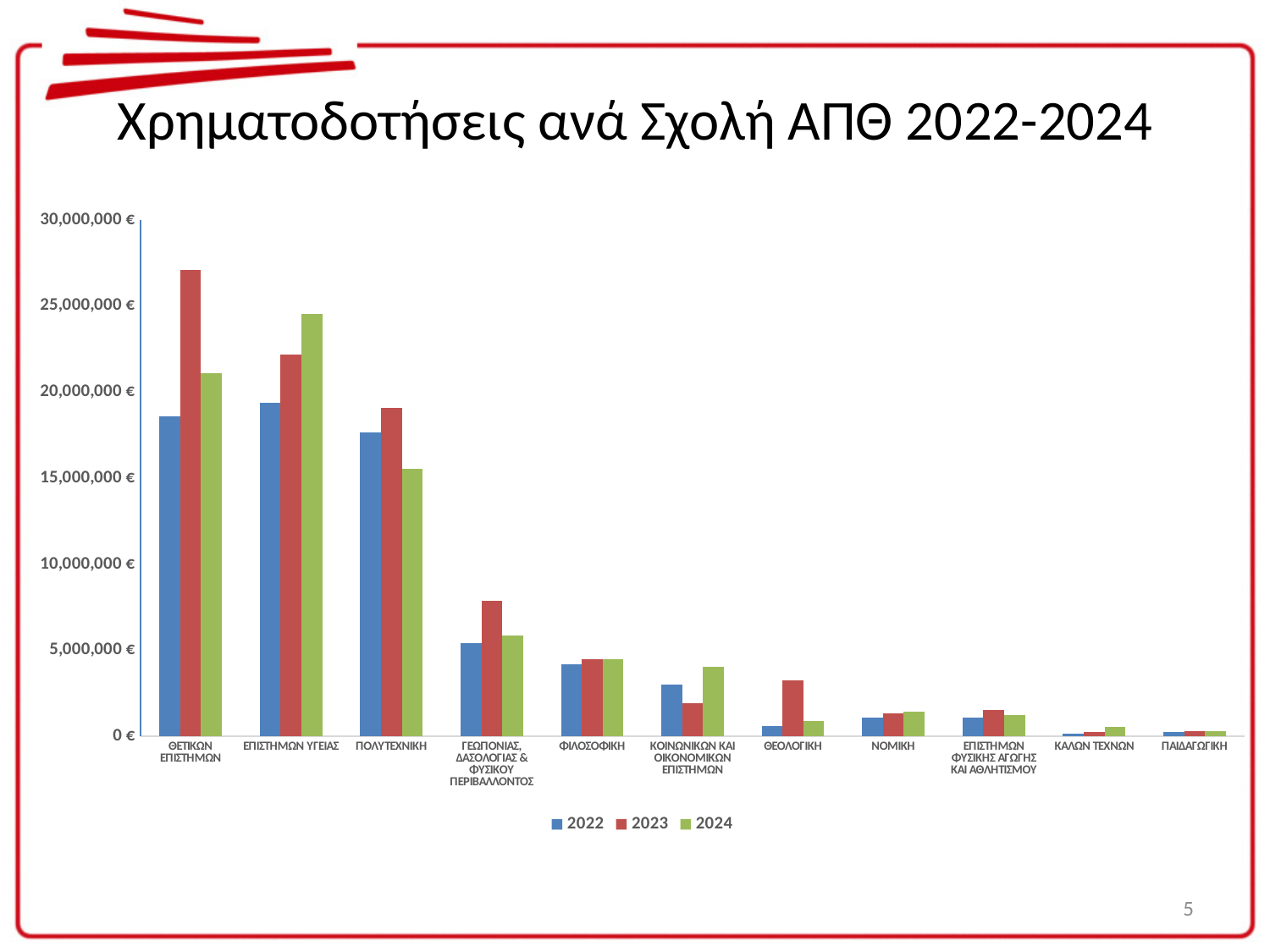
How many schools (categories) are shown on the x axis? 11 Is the 2023 value for ΓΕΩΠΟΝΙΑΣ, ΔΑΣΟΛΟΓΙΑΣ & ΦΥΣΙΚΟΥ ΠΕΡΙΒΑΛΛΟΝΤΟΣ greater or less than 5,000,000 €? greater For ΚΟΙΝΩΝΙΚΩΝ ΚΑΙ ΟΙΚΟΝΟΜΙΚΩΝ ΕΠΙΣΤΗΜΩΝ, which year has the larger value, 2023 or 2024? 2024 Is the 2022 value for ΘΕΟΛΟΓΙΚΗ greater or less than 5,000,000 €? less Is the 2023 value for ΘΕΤΙΚΩΝ ΕΠΙΣΤΗΜΩΝ greater or less than 25,000,000 €? greater How many series does the legend list? 3 What kind of chart is shown on the slide? bar chart Which colour represents the 2024 series in the legend? green Which school has the highest value for 2024? ΕΠΙΣΤΗΜΩΝ ΥΓΕΙΑΣ Which school has the highest value for 2023? ΘΕΤΙΚΩΝ ΕΠΙΣΤΗΜΩΝ For ΘΕΟΛΟΓΙΚΗ, which year has the larger value, 2022 or 2023? 2023